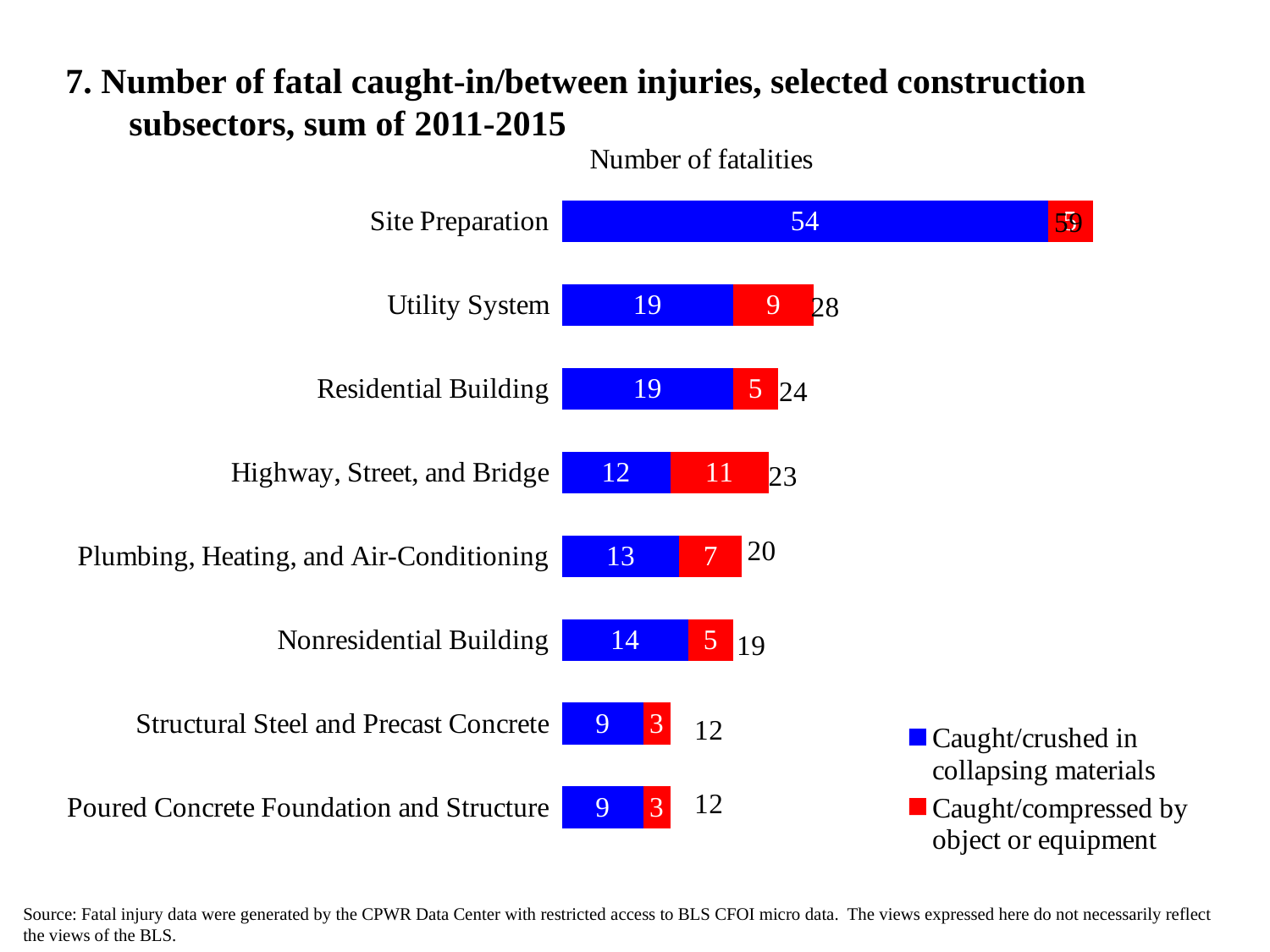
Which subsector has the highest number of fatalities from caught/compressed by object or equipment? Highway, Street, and Bridge What is the total number of fatalities for Plumbing, Heating, and Air-Conditioning? 20 Which is larger for Nonresidential Building: caught/crushed in collapsing materials or caught/compressed by object or equipment? Caught/crushed in collapsing materials What colour represents caught/compressed by object or equipment in the chart? Red What is the number of fatalities from caught/compressed by object or equipment for Highway, Street, and Bridge? 11 How many construction subsectors are shown in the chart? 8 What is the number of fatalities from caught/crushed in collapsing materials for Utility System? 19 What type of chart is shown on the slide? Stacked bar chart What is the difference between the caught/crushed in collapsing materials value and the caught/compressed by object or equipment value for Residential Building? 14 How many series does the legend list? 2 Which subsector has the highest number of fatalities from caught/crushed in collapsing materials? Site Preparation What is the total number of fatalities for Structural Steel and Precast Concrete? 12